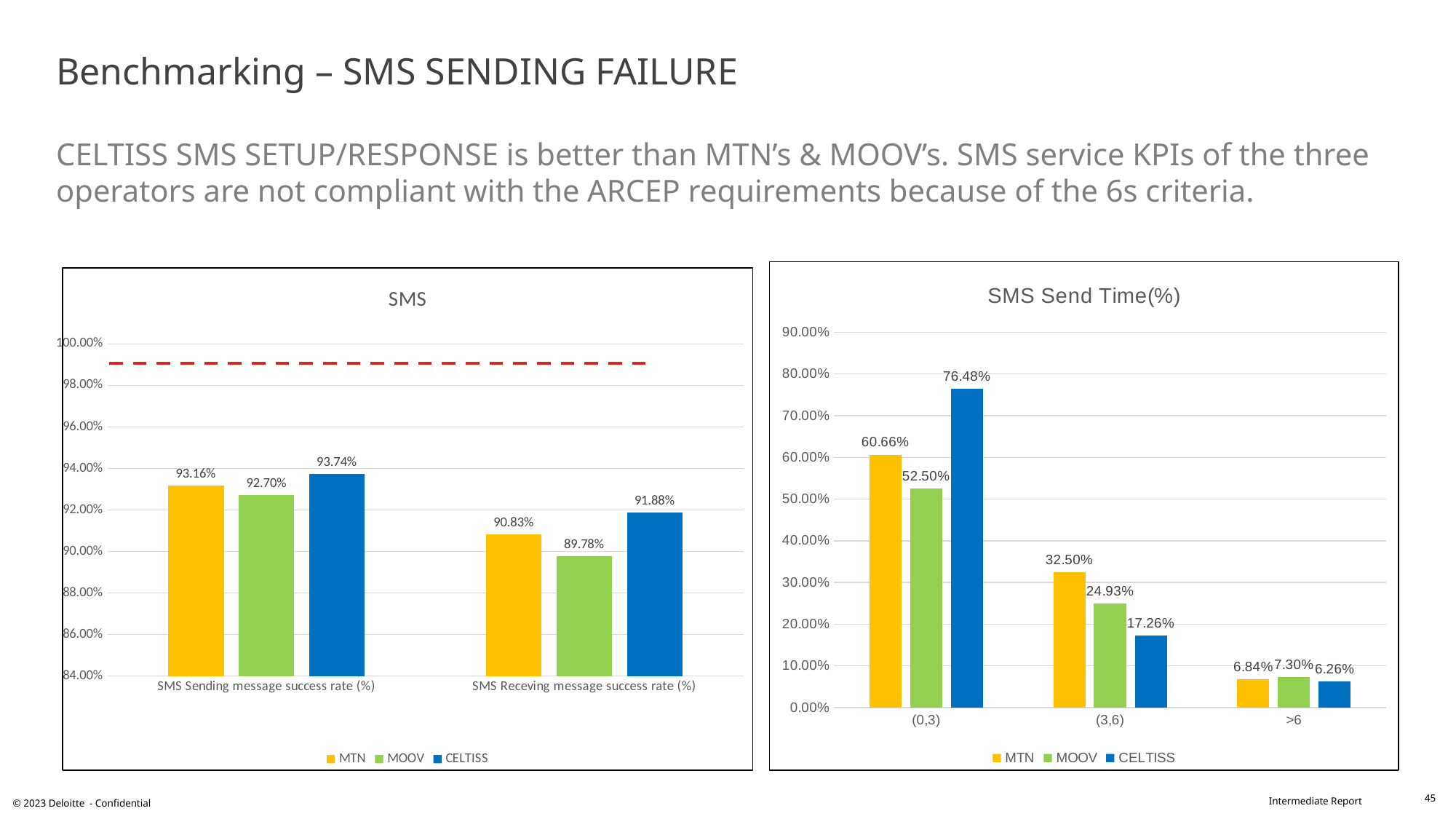
In the 'SMS Send Time(%)' chart, how many categories are shown on the x axis? 3 In the 'SMS' chart, which operator has the lowest SMS Sending message success rate (%)? MOOV In the 'SMS' chart, what is the value for CELTISS for SMS Sending message success rate (%)? 93.74% In the 'SMS Send Time(%)' chart, what is the value for CELTISS in the (0,3) category? 76.48% In the 'SMS' chart, what is the value for MOOV for SMS Receving message success rate (%)? 89.78% In the 'SMS' chart, how many series does the legend list? 3 In the 'SMS Send Time(%)' chart, which operator has the highest value in the >6 category? MOOV In the 'SMS Send Time(%)' chart, what is the value for MOOV in the (3,6) category? 24.93% What kind of chart is the 'SMS Send Time(%)' chart? Bar chart In the 'SMS' chart, is the value for MTN for SMS Receving message success rate (%) greater or less than 92.00%? less In the 'SMS Send Time(%)' chart, what is the difference between MTN and CELTISS in the (3,6) category? 15.24% In the 'SMS' chart, what is the difference between CELTISS and MTN for SMS Receving message success rate (%)? 1.05%